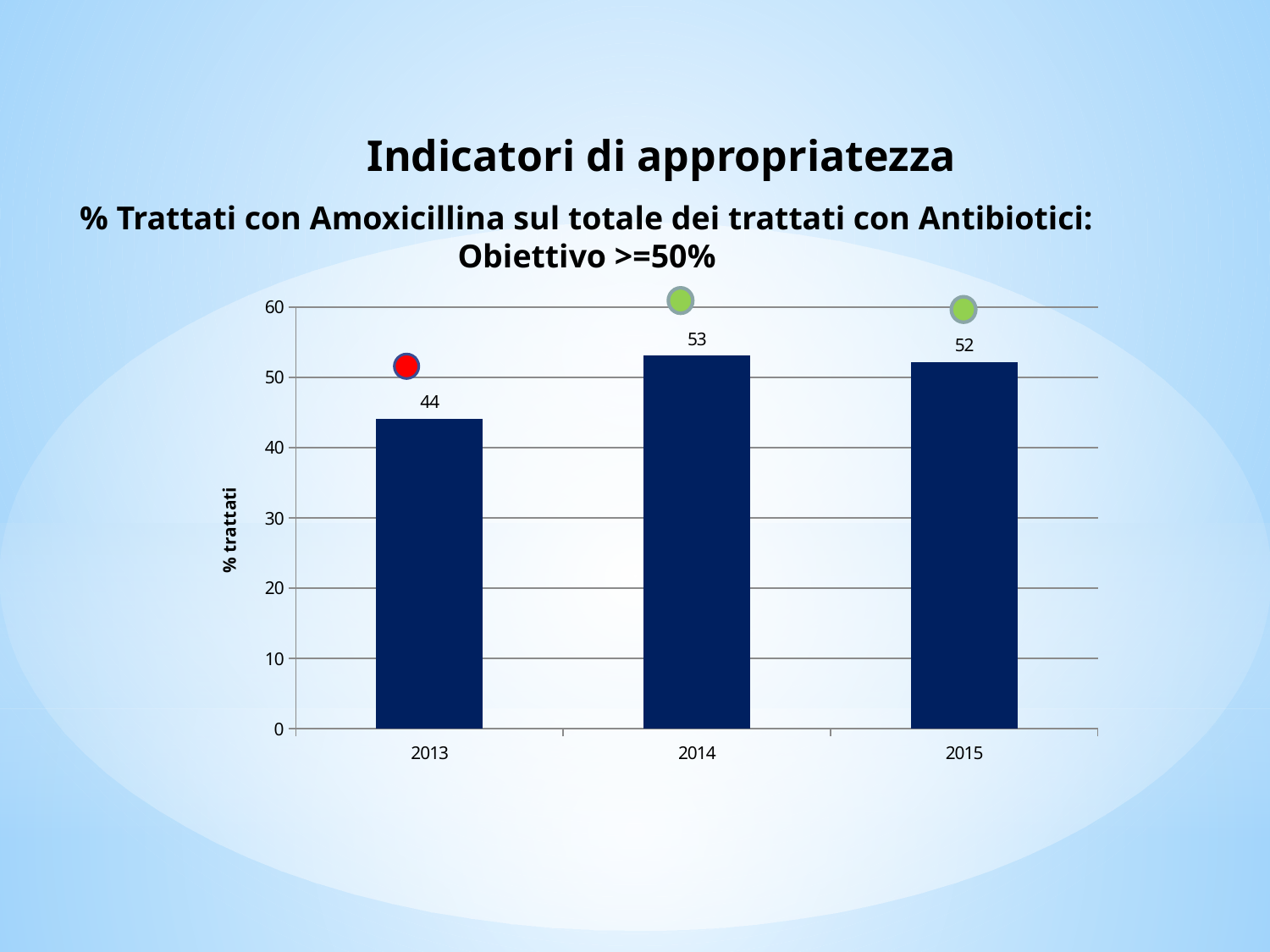
What is the difference between the values for 2014 and 2013? 9 Is the value for 2013 greater or less than 50? less What is the value for 2015? 52 What is the label of the vertical axis? % trattati Which year has the highest value? 2014 Which is larger, the value for 2013 or the value for 2015? 2015 What is the value for 2014? 53 What is the value for 2013? 44 How many years are shown on the x axis? 3 Which year has the lowest value? 2013 What is the target (Obiettivo) stated in the chart title? >=50% What kind of chart is shown on the slide? bar chart